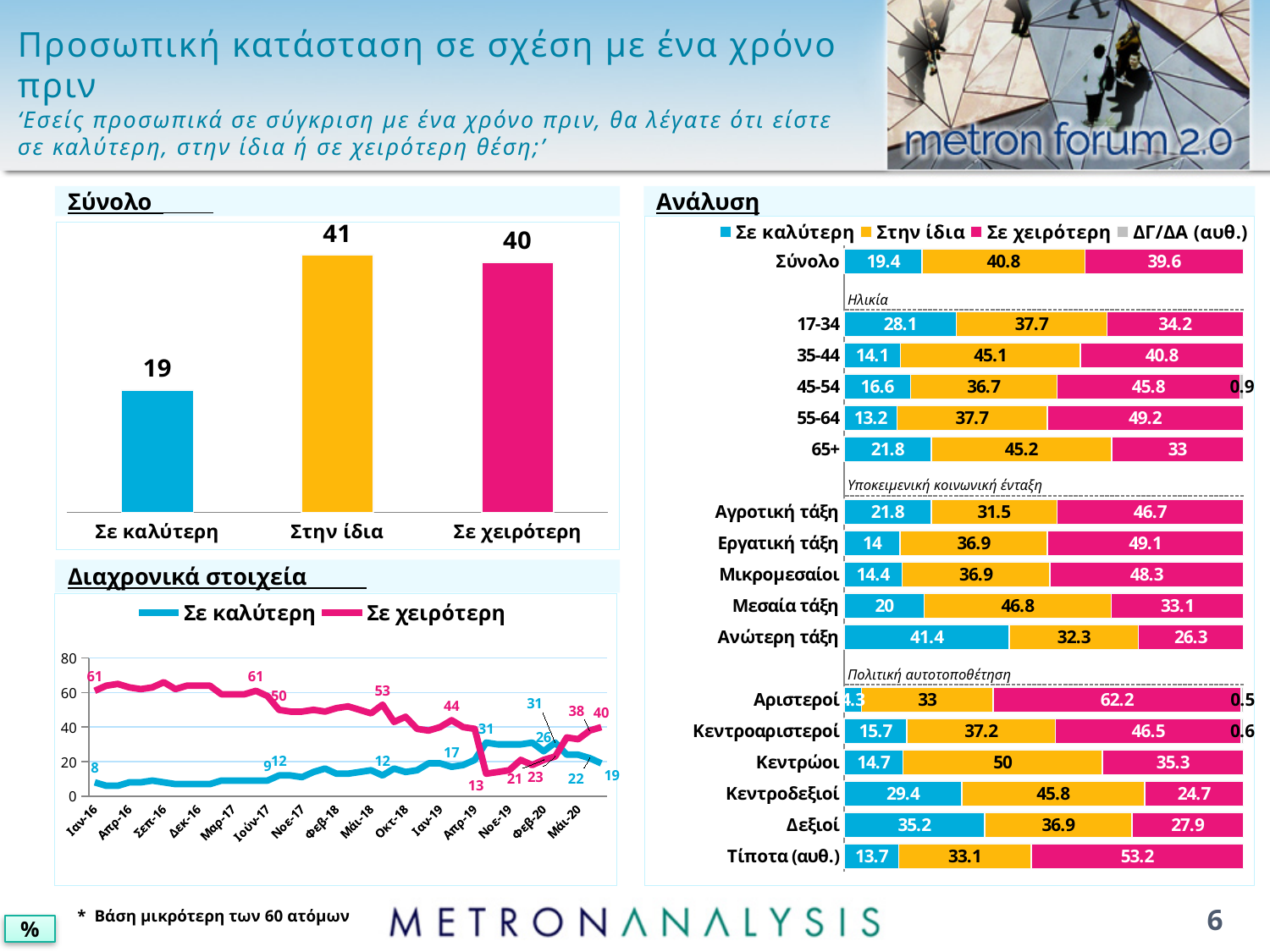
In the 'Διαχρονικά στοιχεία' line chart, what is the last labelled value of the 'Σε χειρότερη' series? 40 In the 'Σύνολο' bar chart, what is the difference between 'Στην ίδια' and 'Σε καλύτερη'? 22 In the 'Διαχρονικά στοιχεία' line chart, how many series does the legend list? 2 What kind of chart is the 'Σύνολο' chart? bar chart In the 'Σύνολο' bar chart, which category has the highest value? Στην ίδια In the 'Ανάλυση' chart, how many series does the legend list? 4 In the 'Ανάλυση' chart, what is the 'Σε καλύτερη' value for the 'Σύνολο' row? 19.4 In the 'Διαχρονικά στοιχεία' line chart, does the 'Σε χειρότερη' series overall rise or fall from Ιαν-16 to Μάι-20? fall In the 'Ανάλυση' chart, which has the larger 'Σε καλύτερη' value, 'Δεξιοί' or 'Κεντροδεξιοί'? Δεξιοί In the 'Σύνολο' bar chart, what is the value for 'Σε καλύτερη'? 19 In the 'Ανάλυση' chart, which age group has the highest 'Σε χειρότερη' value? 55-64 In the 'Ανάλυση' chart, what is the 'Σε χειρότερη' value for 'Αριστεροί'? 62.2